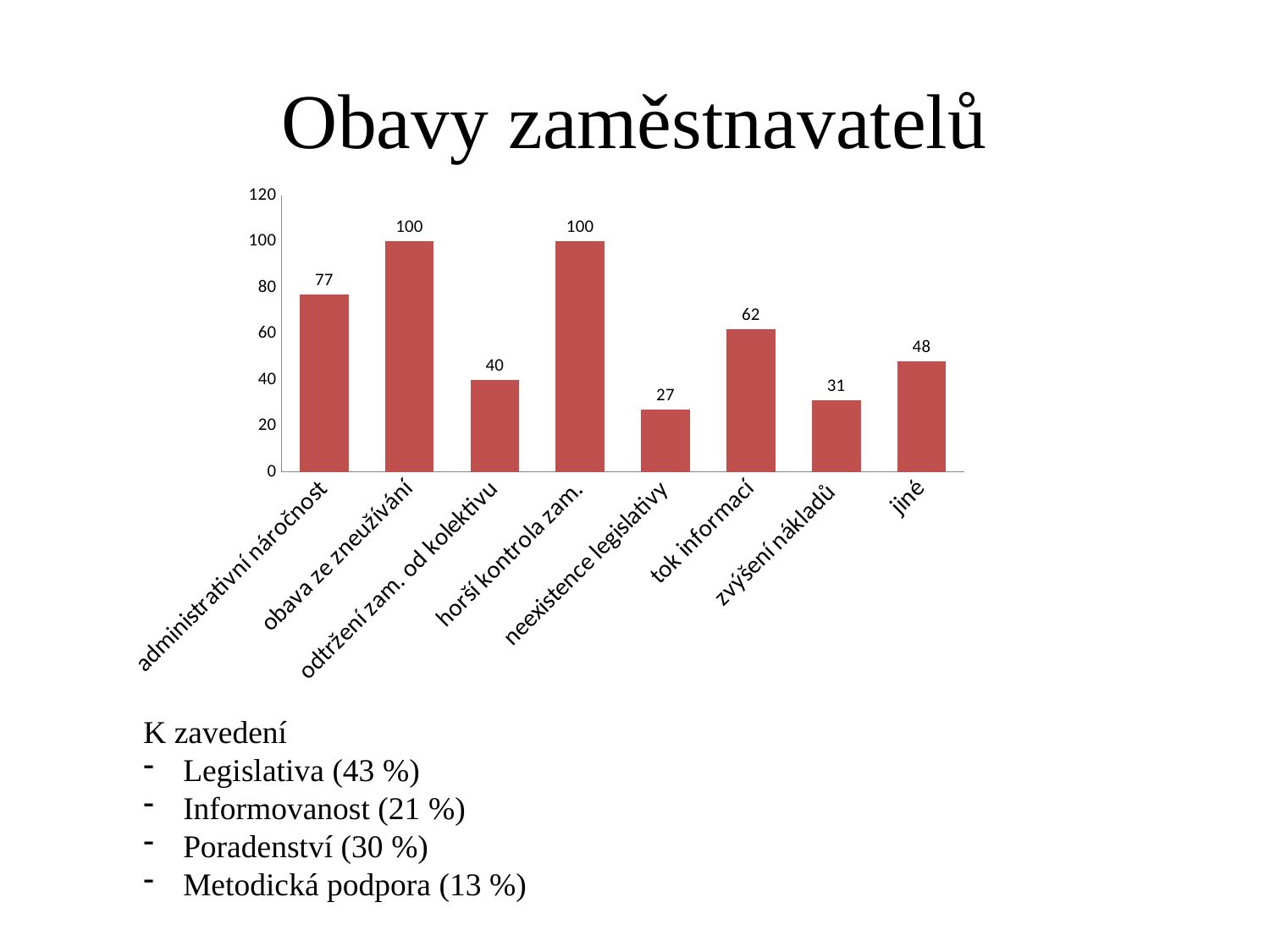
What is the value for tok informací? 62 Which category has the lowest value? neexistence legislativy How many categories are shown on the x axis? 8 Is the value for zvýšení nákladů greater or less than 40? less What is the difference between the values for obava ze zneužívání and zvýšení nákladů? 69 What is the value for administrativní náročnost? 77 What is the title of the slide containing the chart? Obavy zaměstnavatelů What is the value for odtržení zam. od kolektivu? 40 What kind of chart is shown on the slide? bar chart What is the difference between the values for administrativní náročnost and tok informací? 15 Which is larger, the value for jiné or the value for odtržení zam. od kolektivu? jiné What is the value for jiné? 48